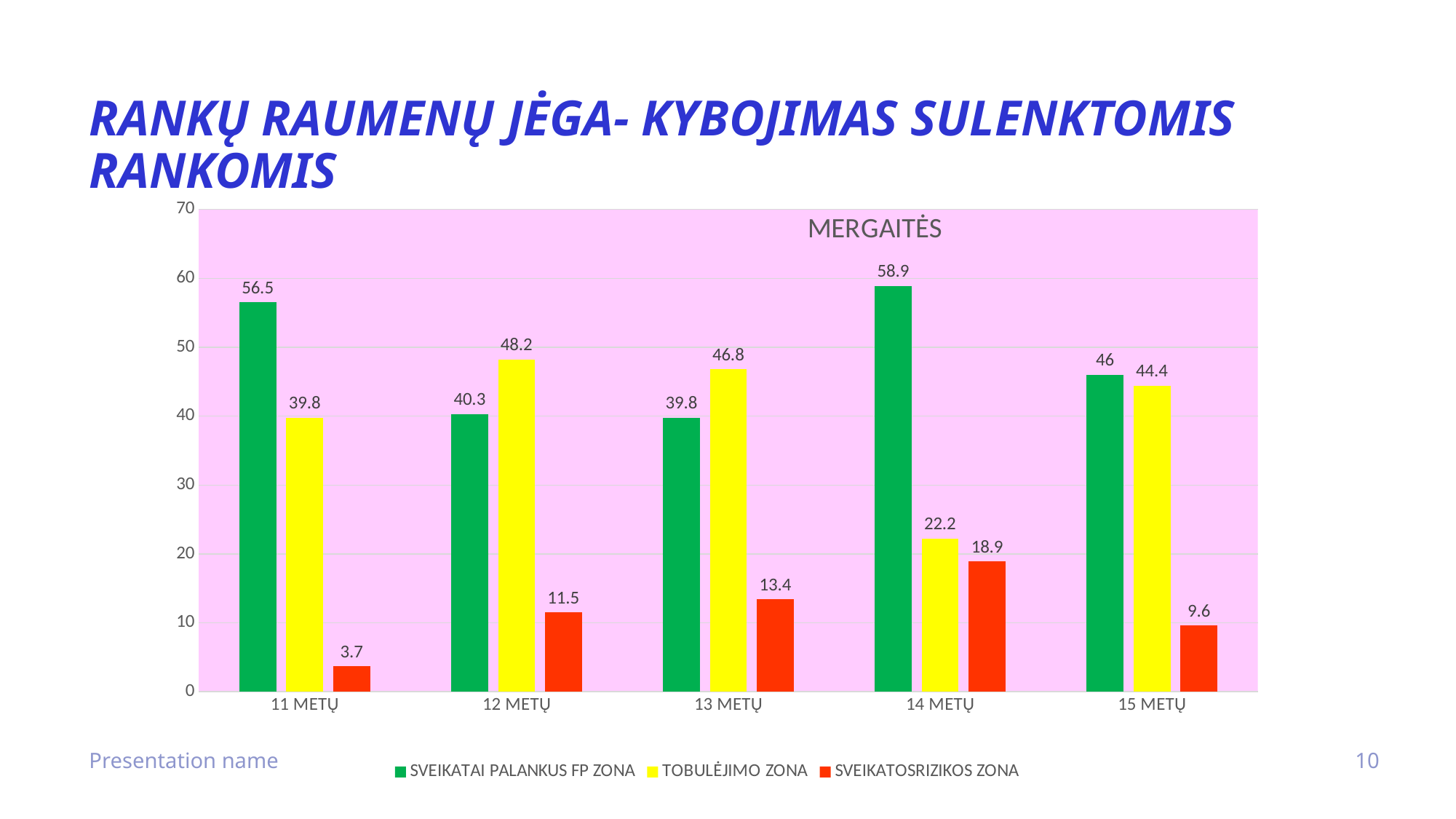
Is the value of SVEIKATOSRIZIKOS ZONA for 15 METŲ greater or less than 10? less What kind of chart is shown on the slide? bar chart What is the value of SVEIKATOSRIZIKOS ZONA for 11 METŲ? 3.7 What is the difference between the SVEIKATAI PALANKUS FP ZONA values for 14 METŲ and 11 METŲ? 2.4 Which age group has the lowest value for TOBULĖJIMO ZONA? 14 METŲ Which is larger for 13 METŲ: SVEIKATAI PALANKUS FP ZONA or TOBULĖJIMO ZONA? TOBULĖJIMO ZONA How many series does the legend list? 3 What is the value of SVEIKATAI PALANKUS FP ZONA for 14 METŲ? 58.9 What is the value of TOBULĖJIMO ZONA for 12 METŲ? 48.2 How many age groups are shown on the x axis? 5 Which age group has the highest value for SVEIKATOSRIZIKOS ZONA? 14 METŲ What is the title shown inside the chart area? MERGAITĖS